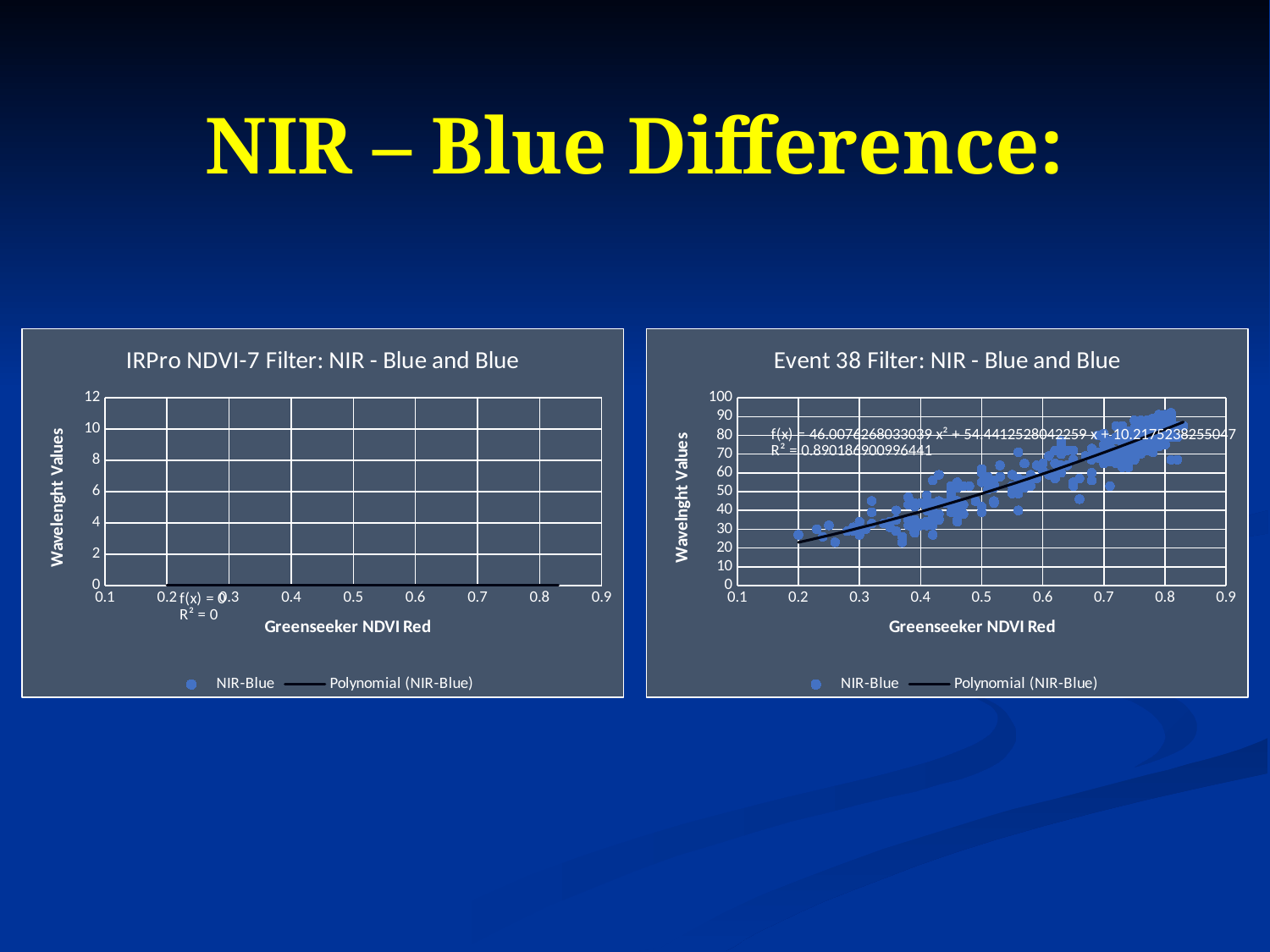
What kind of chart is the 'IRPro NDVI-7 Filter: NIR - Blue and Blue' chart? Scatter chart What is the maximum value shown on the y-axis of the 'Event 38 Filter: NIR - Blue and Blue' chart? 100 What R² value is printed on the 'Event 38 Filter: NIR - Blue and Blue' chart? 0.890186900996441 In the 'Event 38 Filter: NIR - Blue and Blue' chart, do the NIR-Blue values rise or fall as Greenseeker NDVI Red increases? Rise How many entries does the legend of the 'IRPro NDVI-7 Filter: NIR - Blue and Blue' chart list? 2 In the 'Event 38 Filter: NIR - Blue and Blue' chart, are the NIR-Blue values near Greenseeker NDVI Red 0.8 greater or less than 70? greater In the 'Event 38 Filter: NIR - Blue and Blue' chart, are the NIR-Blue values near Greenseeker NDVI Red 0.2 greater or less than 50? less What kind of chart is the 'Event 38 Filter: NIR - Blue and Blue' chart? Scatter chart What R² value is printed on the 'IRPro NDVI-7 Filter: NIR - Blue and Blue' chart? 0 What is the x-axis title of the 'Event 38 Filter: NIR - Blue and Blue' chart? Greenseeker NDVI Red How many entries does the legend of the 'Event 38 Filter: NIR - Blue and Blue' chart list? 2 What is the maximum value shown on the y-axis of the 'IRPro NDVI-7 Filter: NIR - Blue and Blue' chart? 12